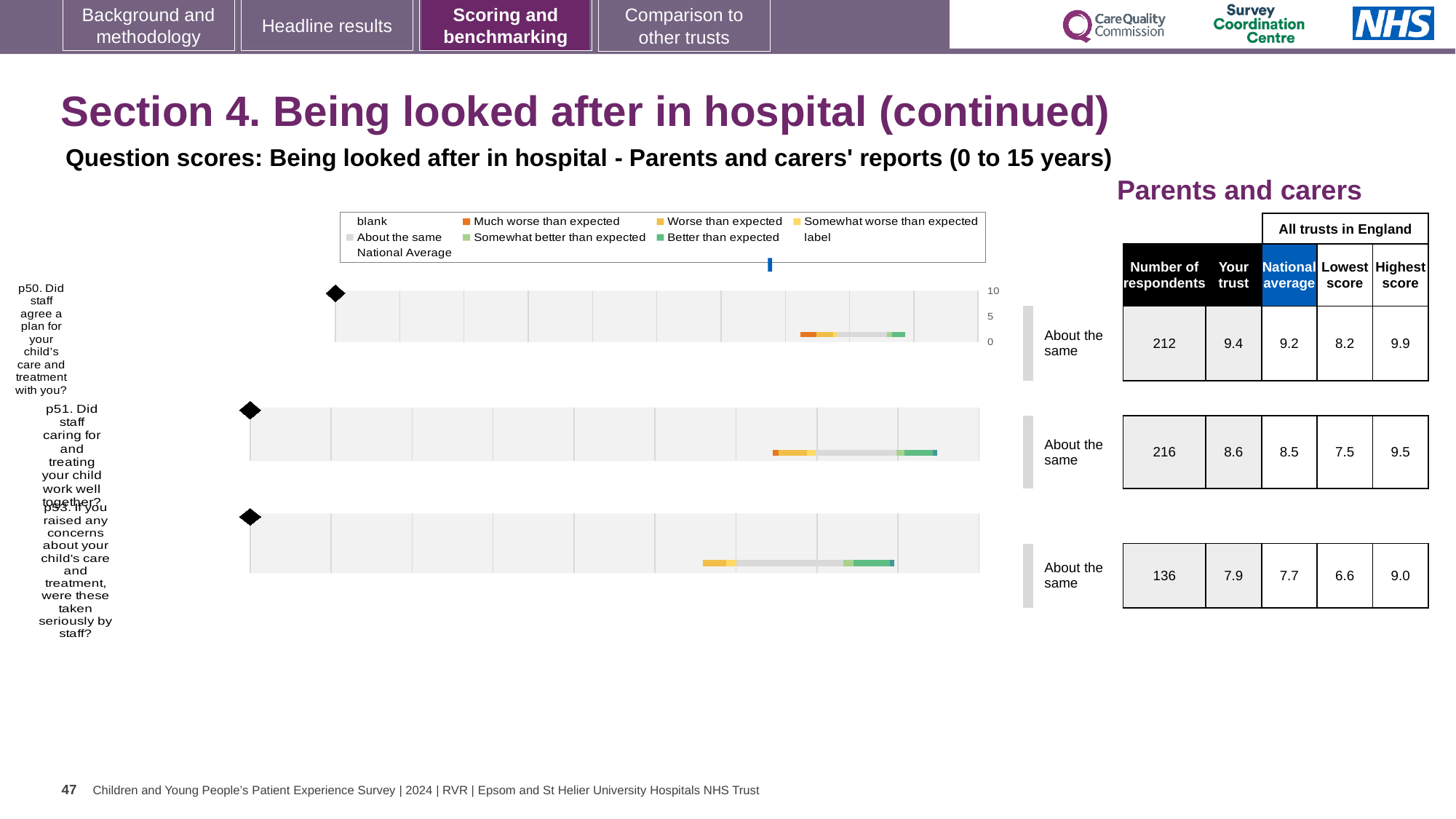
How many question charts are shown on the slide? 3 What is the 'Your trust' score for p50 (Did staff agree a plan for your child's care and treatment with you)? 9.4 What is the difference between the 'Your trust' score and the national average for p50? 0.2 What is the highest value shown on the vertical axis of the p50 chart? 10 For p53, is the 'Your trust' score or the national average larger? Your trust What kind of chart is used to show the benchmark results for p50, p51 and p53? bar chart Which of the three questions has the lowest 'Your trust' score? p53 What benchmark category is shown next to the p50 chart? About the same How many respondents answered p53 (If you raised any concerns about your child's care and treatment, were these taken seriously by staff)? 136 What is the national average score for p51 (Did staff caring for and treating your child work well together)? 8.5 Which of the three questions has the highest 'Highest score' across all trusts in England? p50 What is the lowest score across all trusts in England for p51? 7.5